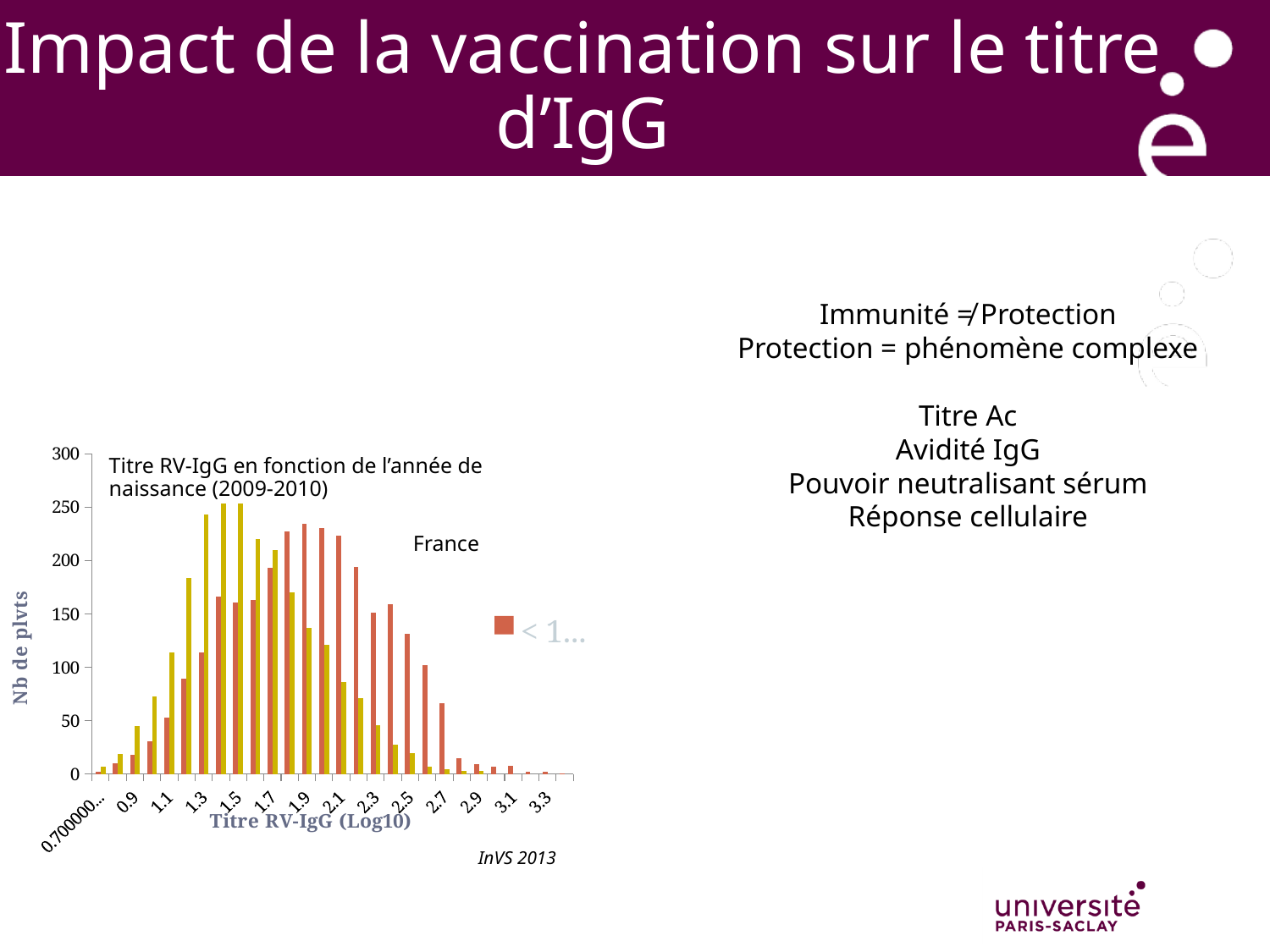
Is the value of the orange bar at 2.7 greater or less than 50? greater Is the value of the yellow bar at 2.1 greater or less than 100? less What kind of chart is shown on the slide? bar chart Do the orange bars rise or fall along the x axis from 2.1 to 3.3? fall Do the yellow bars rise or fall along the x axis from 0.9 to 1.5? rise Is the value of the yellow bar at 1.9 greater or less than 150? less What is the title of the x axis of the chart? Titre RV-IgG (Log10) What is the title of the y axis of the chart? Nb de plvts